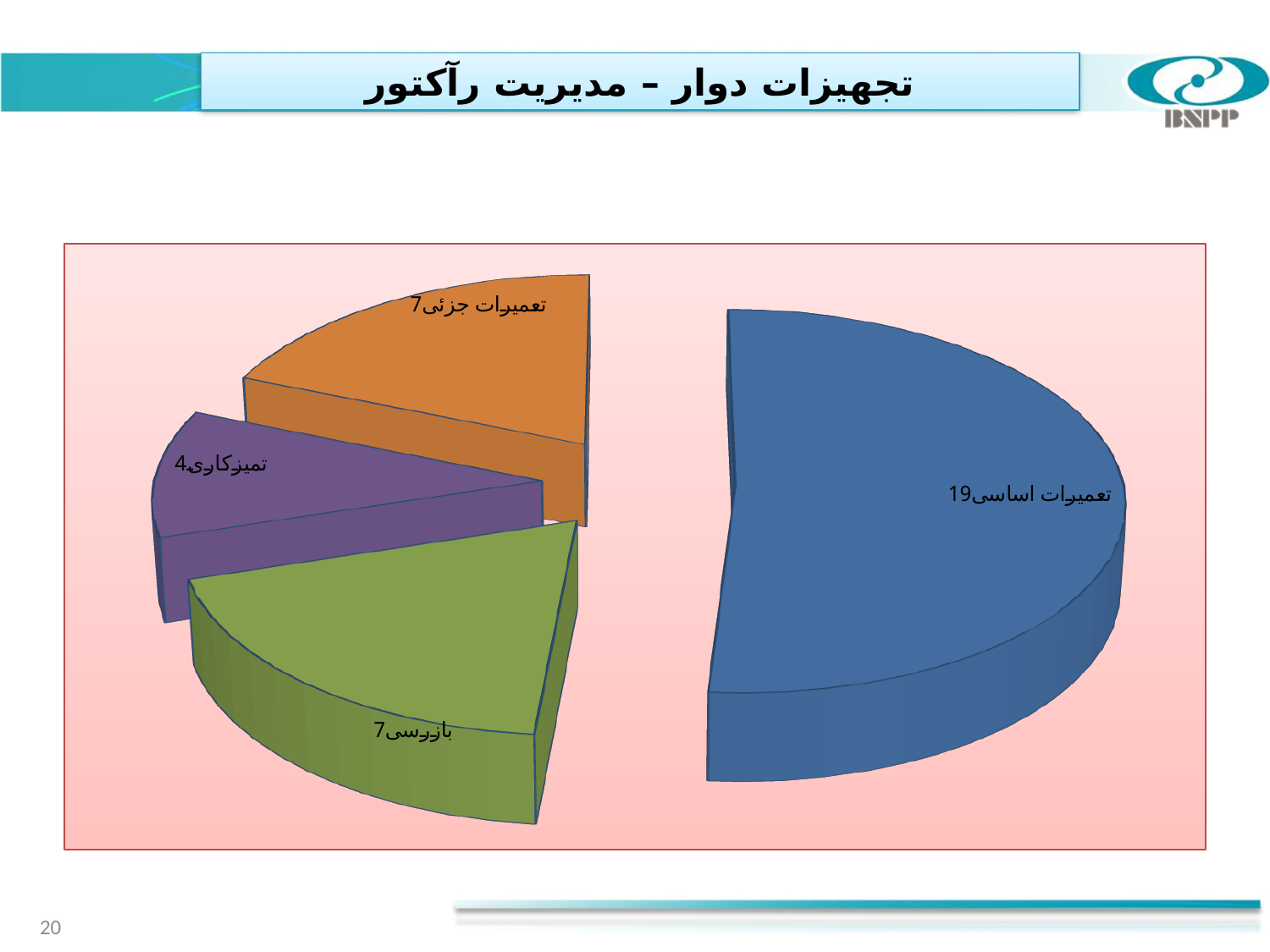
What is the value for تعمیرات جزئی? 7 What is the value for تمیزکاری? 4 Which category has the smallest slice of the pie? تمیزکاری Which is larger, the value for تعمیرات جزئی or the value for تمیزکاری? تعمیرات جزئی How many slices does the pie chart have? 4 What colour is the slice for تعمیرات اساسی? blue What is the value for تعمیرات اساسی? 19 What kind of chart is shown on the slide? pie chart Which category has the largest slice of the pie? تعمیرات اساسی What is the total of all the slice values in the pie chart? 37 What is the difference between the values for تعمیرات اساسی and تمیزکاری? 15 What is the value for بازرسی? 7